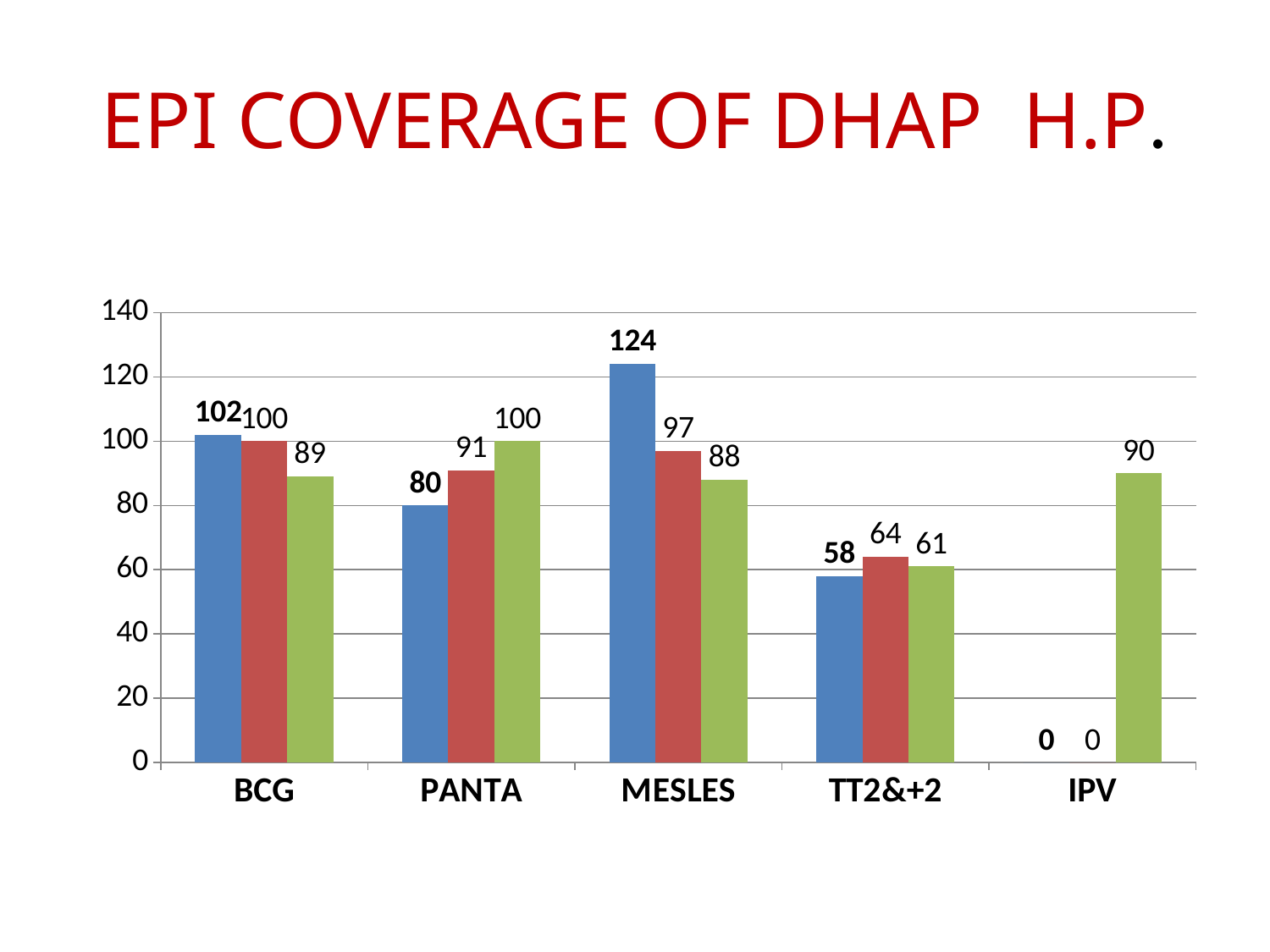
Is the value of the blue bar for MESLES greater or less than 120? greater What is the value of the red bar for PANTA? 91 What kind of chart is shown on the slide? bar chart Which category has the lowest green bar? TT2&+2 What is the value of the red bar for IPV? 0 How many categories are shown on the x axis? 5 Which is larger for PANTA, the blue bar or the green bar? the green bar What is the value of the green bar for IPV? 90 Which category has the highest blue bar? MESLES What is the title of the slide? EPI COVERAGE OF DHAP H.P. What is the value of the blue bar for MESLES? 124 What is the difference between the blue bar for BCG and the blue bar for TT2&+2? 44